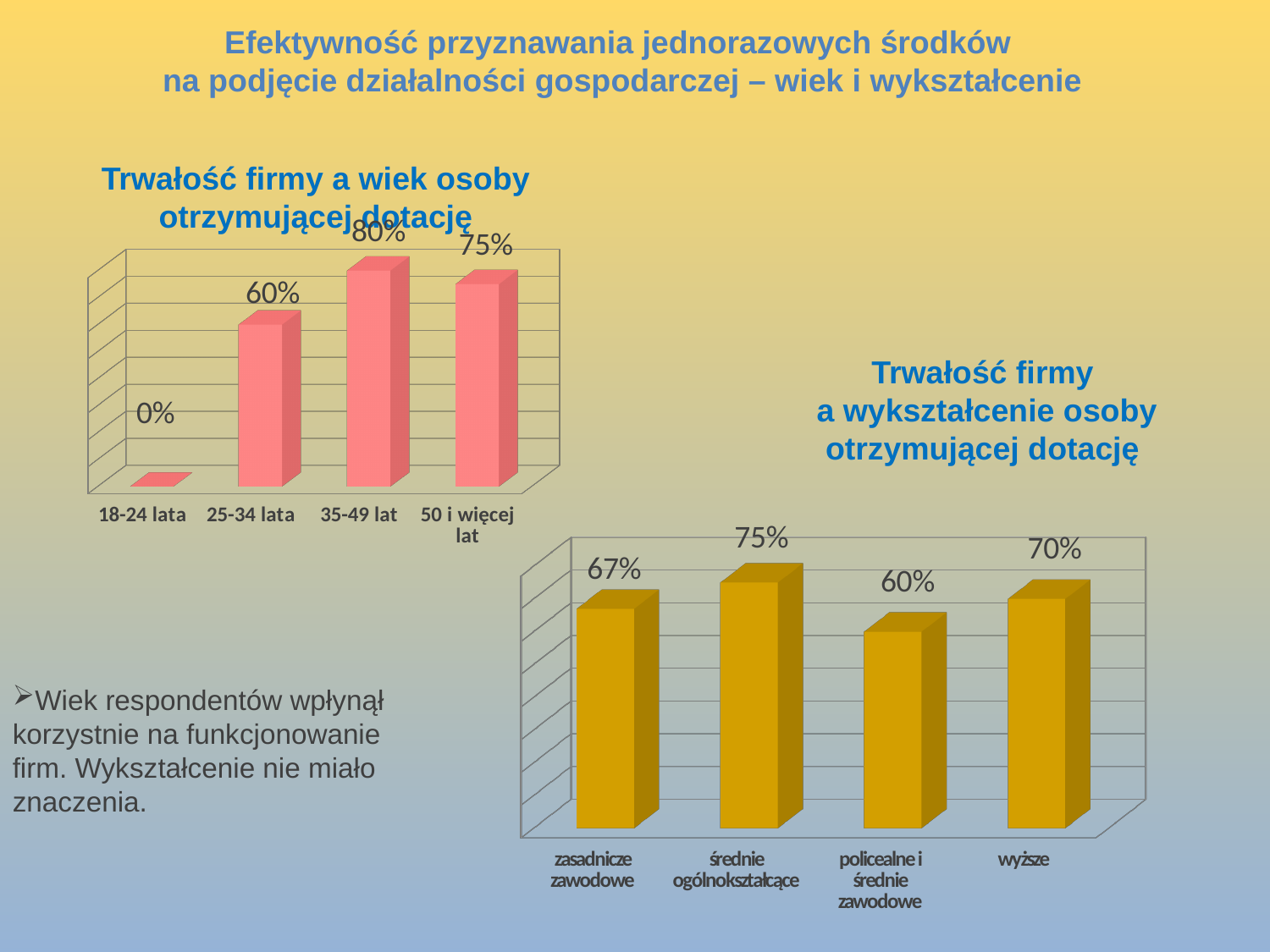
What kind of chart is 'Trwałość firmy a wykształcenie osoby otrzymującej dotację'? bar chart In the chart 'Trwałość firmy a wiek osoby otrzymującej dotację', what is the difference between the values for 35-49 lat and 25-34 lata? 20% In the chart 'Trwałość firmy a wykształcenie osoby otrzymującej dotację', what is the difference between the values for średnie ogólnokształcące and policealne i średnie zawodowe? 15% In the chart 'Trwałość firmy a wykształcenie osoby otrzymującej dotację', what is the value for średnie ogólnokształcące? 75% In the chart 'Trwałość firmy a wiek osoby otrzymującej dotację', what is the value for 18-24 lata? 0% In the chart 'Trwałość firmy a wiek osoby otrzymującej dotację', which age group has the highest value? 35-49 lat In the chart 'Trwałość firmy a wiek osoby otrzymującej dotację', how many age categories are shown? 4 In the chart 'Trwałość firmy a wiek osoby otrzymującej dotację', what is the value for 35-49 lat? 80% In the chart 'Trwałość firmy a wykształcenie osoby otrzymującej dotację', which is larger: the value for zasadnicze zawodowe or for wyższe? wyższe In the chart 'Trwałość firmy a wykształcenie osoby otrzymującej dotację', which education category has the lowest value? policealne i średnie zawodowe In the chart 'Trwałość firmy a wykształcenie osoby otrzymującej dotację', what is the value for wyższe? 70% In the chart 'Trwałość firmy a wiek osoby otrzymującej dotację', which age group has the lowest value? 18-24 lata